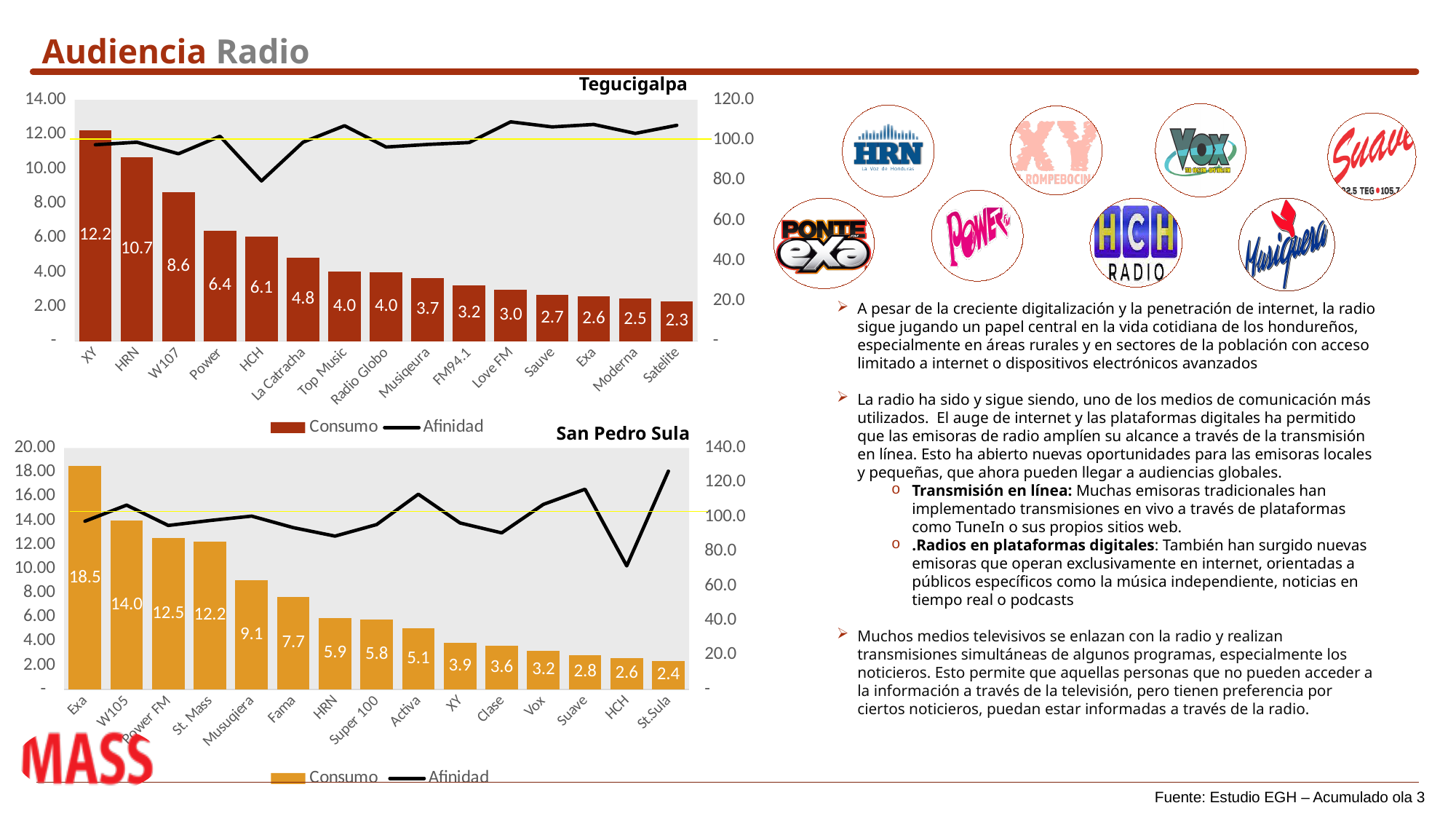
On the San Pedro Sula chart, do the Consumo values rise or fall from left to right along the x axis? fall On the Tegucigalpa chart, which station has the highest Consumo? XY On the Tegucigalpa chart, how many stations are shown on the x axis? 15 On the San Pedro Sula chart, how many series does the legend list? 2 On the Tegucigalpa chart, is the Afinidad value for HCH greater or less than 100? less On the San Pedro Sula chart, which station has the highest Consumo? Exa On the Tegucigalpa chart, what is the Consumo value for HRN? 10.7 On the San Pedro Sula chart, what is the Consumo value for Musuqiera? 9.1 On the San Pedro Sula chart, which has the larger Consumo, Fama or HRN? Fama On the Tegucigalpa chart, which station has the lowest Consumo? Satelite On the Tegucigalpa chart, what is the difference in Consumo between XY and W107? 3.6 On the San Pedro Sula chart, is the Afinidad value for HCH greater or less than 80? less